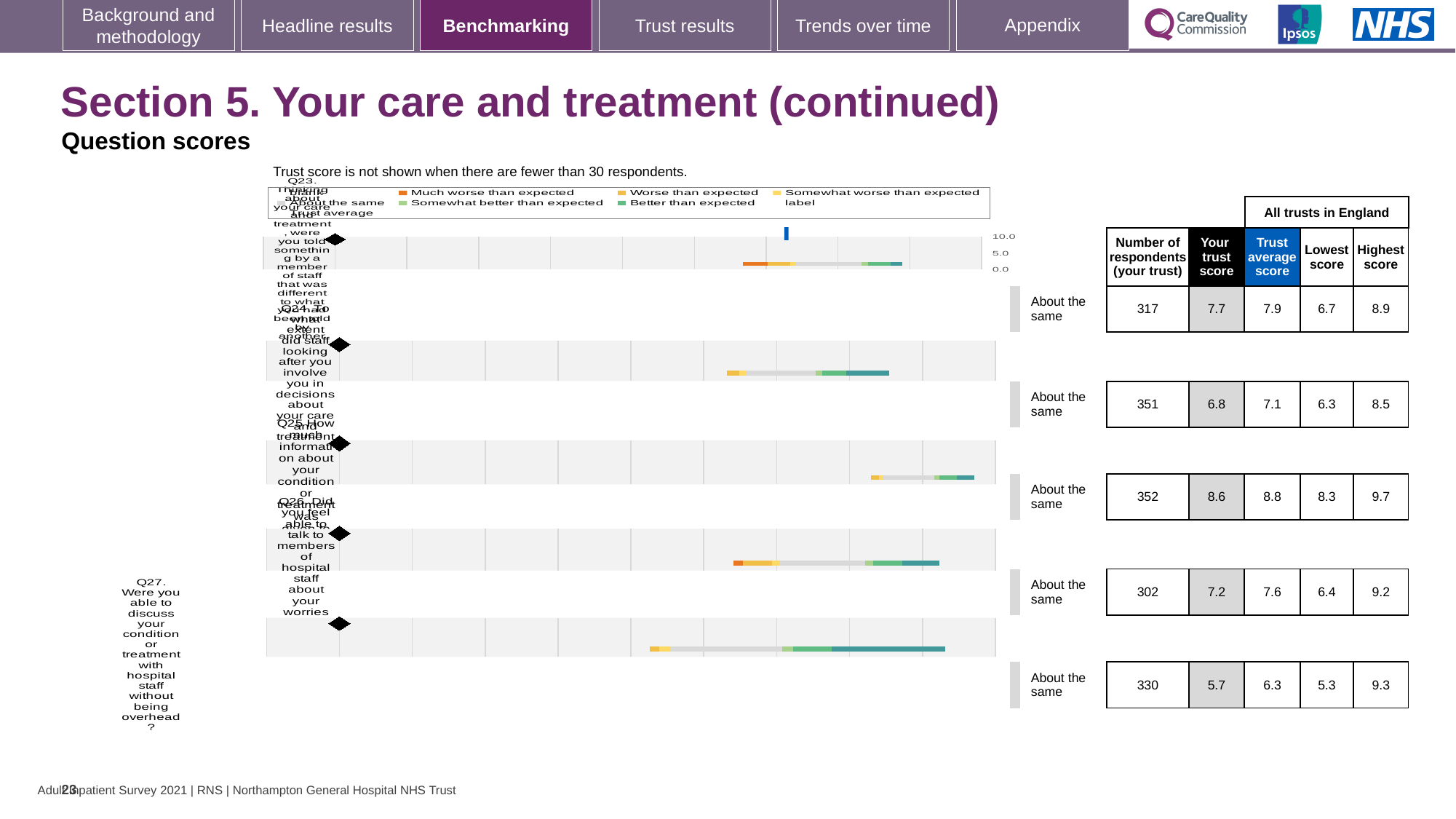
How many questions (Q23 to Q27) are plotted on the chart? 5 How many respondents (your trust) are shown for Q24? 351 Which question has the highest 'Your trust score'? Q25 What is the difference between the trust average score and your trust score for Q23? 0.2 Which question has the lowest 'Your trust score'? Q27 What is the difference between the highest and lowest scores for Q27? 4.0 What benchmark category is shown for every question on this slide? About the same For Q24, which is larger: your trust score or the trust average score? Trust average score What is the lowest score across all trusts in England for Q26? 6.4 What is the trust average score for Q25? 8.8 What is the 'Your trust score' for Q23? 7.7 What is the highest score across all trusts in England for Q27? 9.3